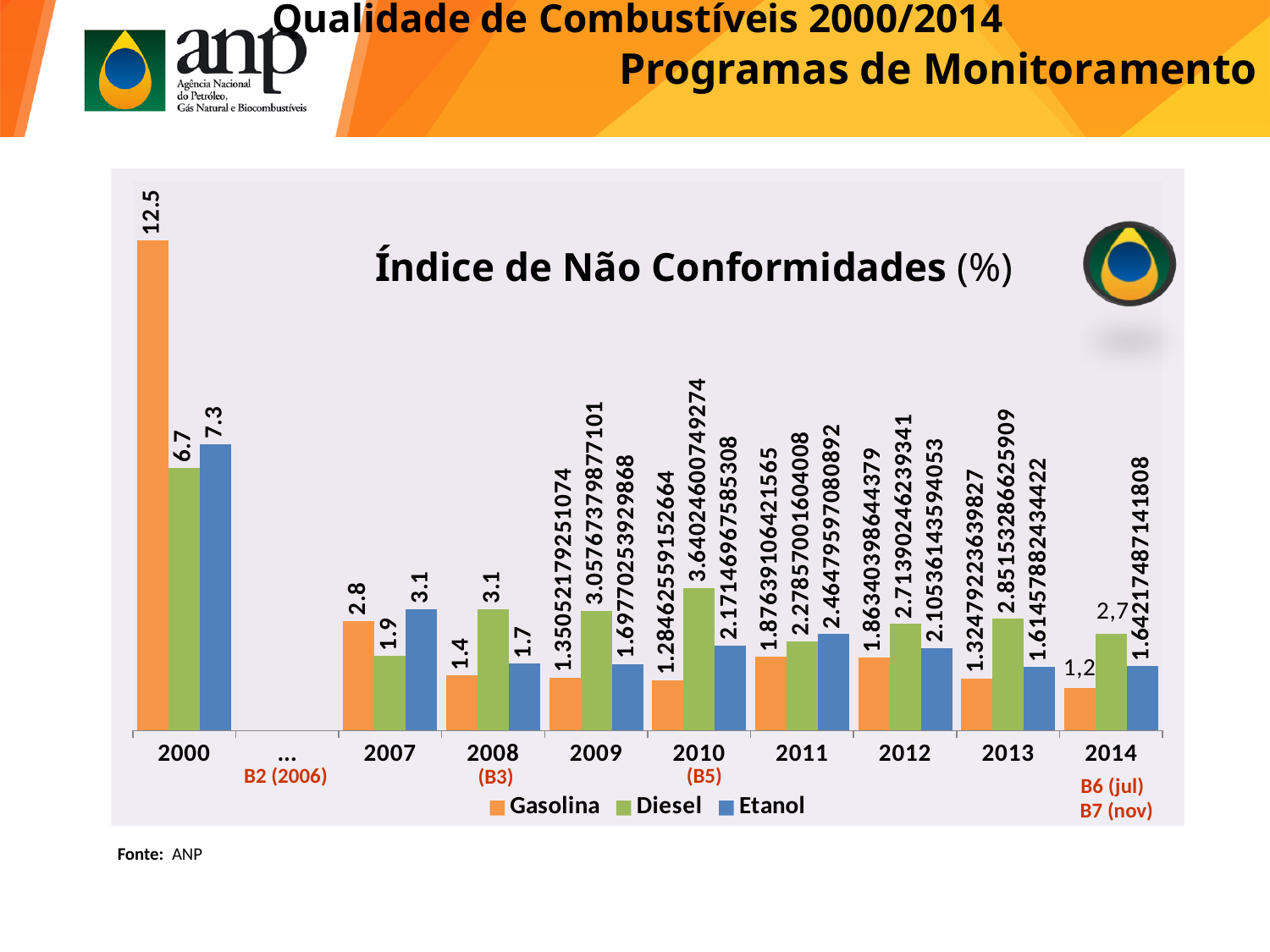
What is the difference between the Gasolina and Diesel values in 2000? 5.8 Which series are listed in the chart's legend? Gasolina, Diesel, Etanol What is the Gasolina value for 2000? 12.5 In which year is the Gasolina value highest? 2000 What is the Diesel value for 2008? 3.1 Which series has the highest value in 2000? Gasolina What kind of chart is shown on the slide? bar chart How many series does the legend of the chart list? 3 What is the Gasolina value for 2014? 1,2 What is the Etanol value for 2000? 7.3 In 2007, which is larger: the Etanol value or the Gasolina value? Etanol What is the Diesel value for 2007? 1.9